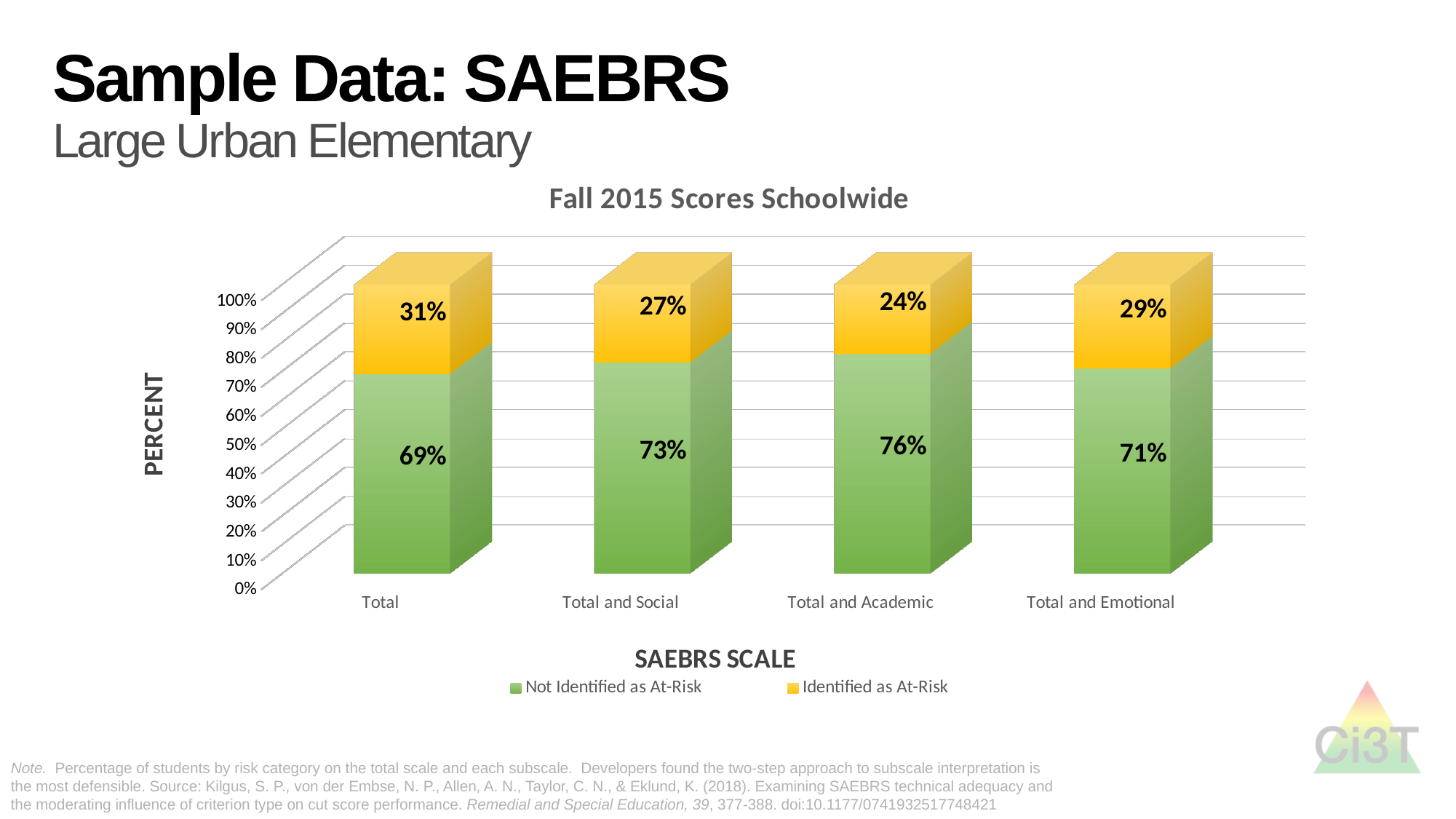
What kind of chart is shown on the slide? Stacked bar chart Which SAEBRS scale has the highest percentage of students Identified as At-Risk? Total What percentage of students were Not Identified as At-Risk on the Total scale? 69% How many SAEBRS scale categories are shown on the x axis? 4 What is the total of the stacked bar for Total and Social? 100% What percentage of students were Identified as At-Risk on the Total and Academic scale? 24% What is the difference between the Not Identified as At-Risk percentages for Total and Academic and Total? 7% How many series does the legend list? 2 What is the title of the chart? Fall 2015 Scores Schoolwide Which is larger: the Identified as At-Risk percentage for Total and Social or for Total and Emotional? Total and Emotional What percentage of students were Identified as At-Risk on the Total and Emotional scale? 29% Which SAEBRS scale has the lowest percentage of students Not Identified as At-Risk? Total